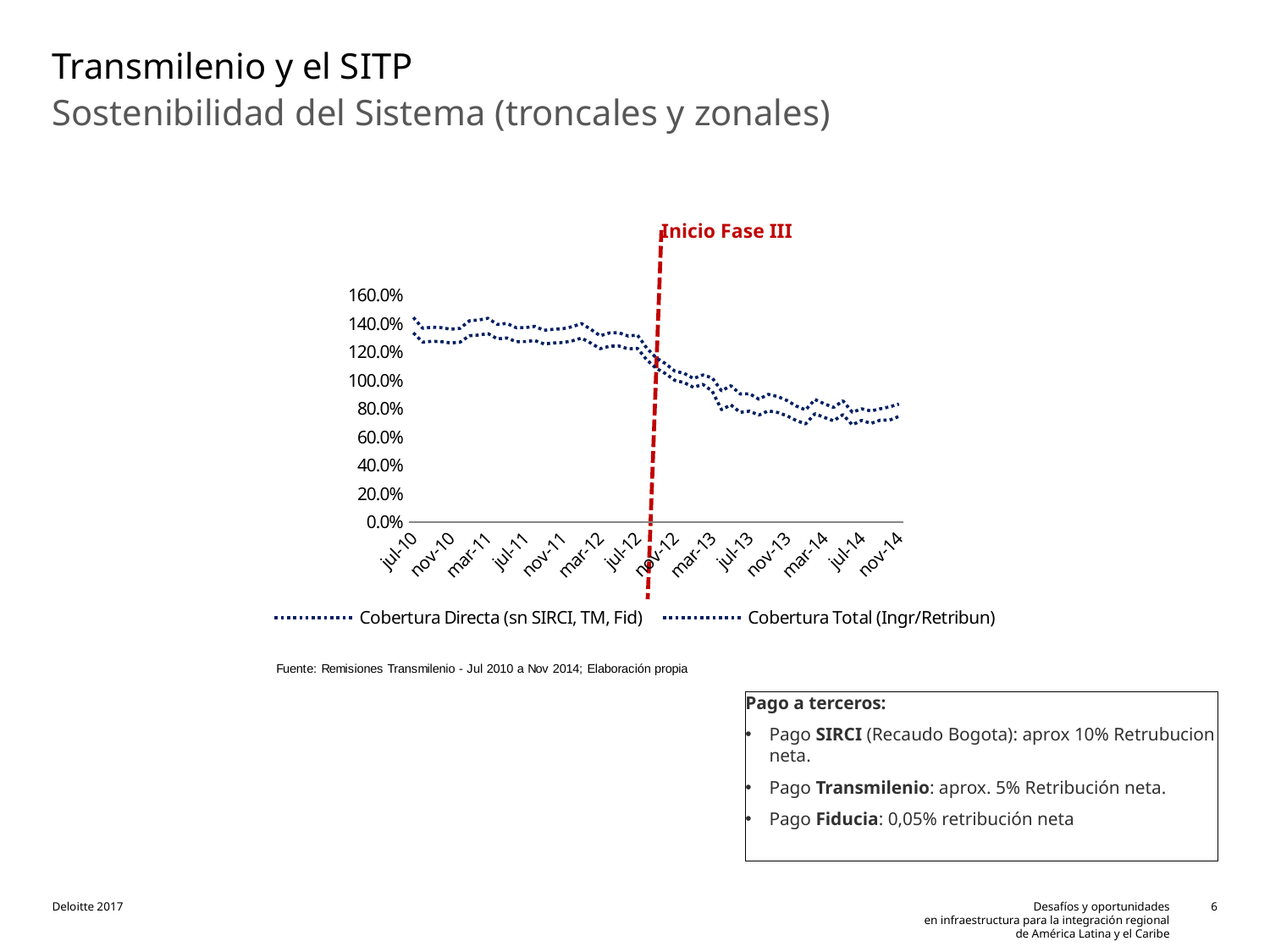
Are the values of both series at nov-13 greater or less than 120.0%? less What is the highest value shown on the chart's vertical axis? 160.0% How many series does the chart legend list? 2 What is the first date label on the chart's x axis? jul-10 Do the plotted values generally rise or fall from jul-10 to nov-14? fall Are both series' values at jul-10 greater or less than 120.0%? greater Which is larger for the upper series: the value at jul-10 or the value at nov-14? jul-10 How many date labels are shown along the x axis of the chart? 14 What event does the red dashed vertical line on the chart mark? Inicio Fase III What kind of chart is shown on the slide? line chart Are both series' values at nov-14 greater or less than 100.0%? less What are the two series named in the chart legend? Cobertura Directa (sn SIRCI, TM, Fid) and Cobertura Total (Ingr/Retribun)